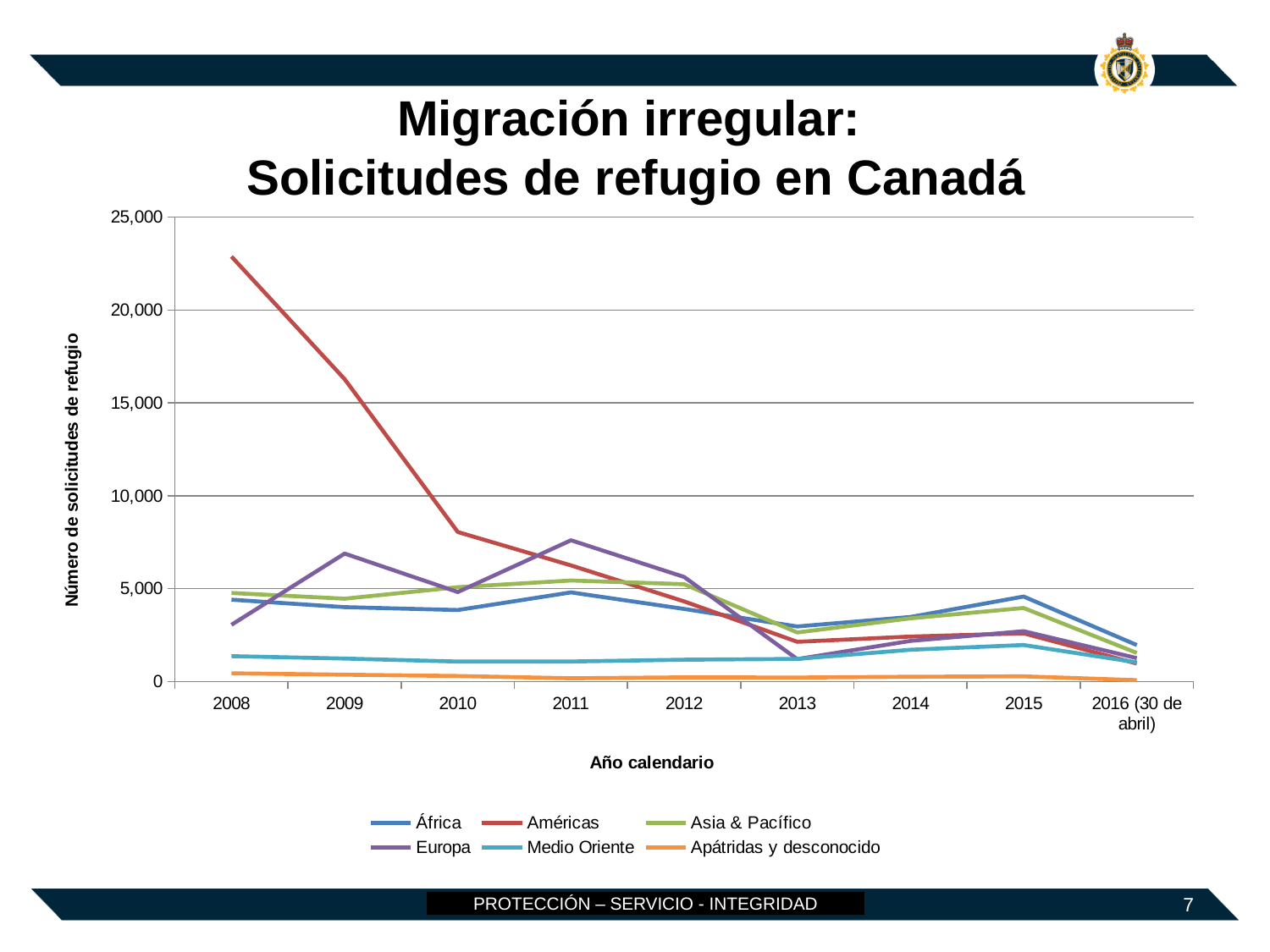
Which series has the highest value in 2008? Américas Is the value for Américas in 2010 greater or less than 10,000? less How many points along the x axis (calendar years) does the chart show? 9 Is the value for Europa in 2011 greater or less than 5,000? greater What kind of chart is shown on the slide? line chart What is the title of the vertical axis? Número de solicitudes de refugio Does the Américas series rise or fall from 2008 to 2013? fall Is the value for Medio Oriente in 2008 greater or less than 5,000? less How many series does the legend list? 6 Which is larger in 2011, the value for Europa or the value for África? Europa Which series has the lowest value in 2008? Apátridas y desconocido